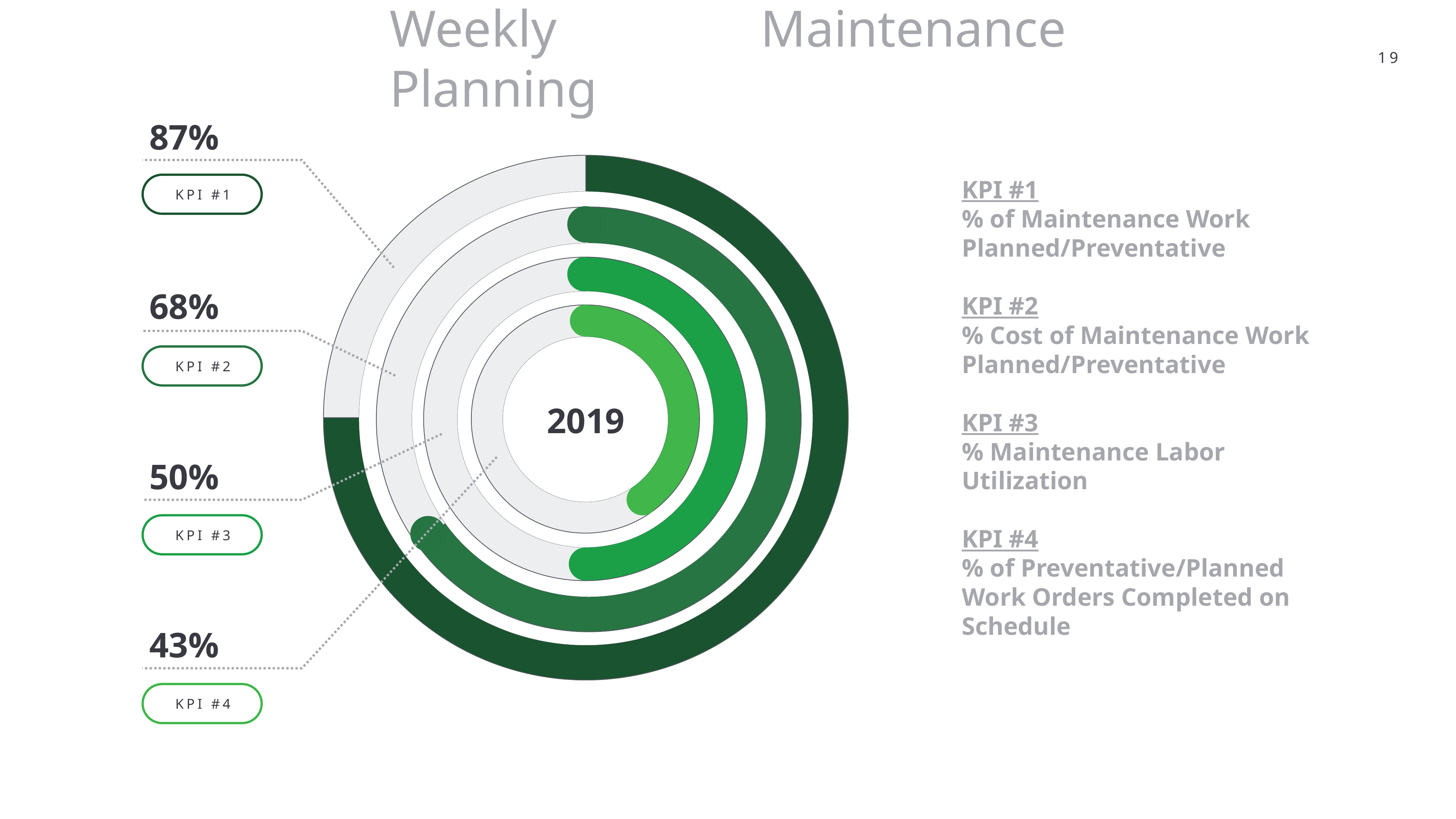
How many KPIs are plotted on the chart? 4 What year is shown in the centre of the chart? 2019 What kind of chart is shown on the slide? Doughnut chart Which KPI has the lowest value? KPI #4 What is the value shown for KPI #4? 43% What is the difference between the values for KPI #1 and KPI #4? 44% What is the value shown for KPI #1? 87% What is the difference between the values for KPI #1 and KPI #2? 19% Which KPI has the highest value? KPI #1 Which is larger, the value for KPI #2 or the value for KPI #3? KPI #2 What is the value shown for KPI #2? 68% What is the value shown for KPI #3? 50%